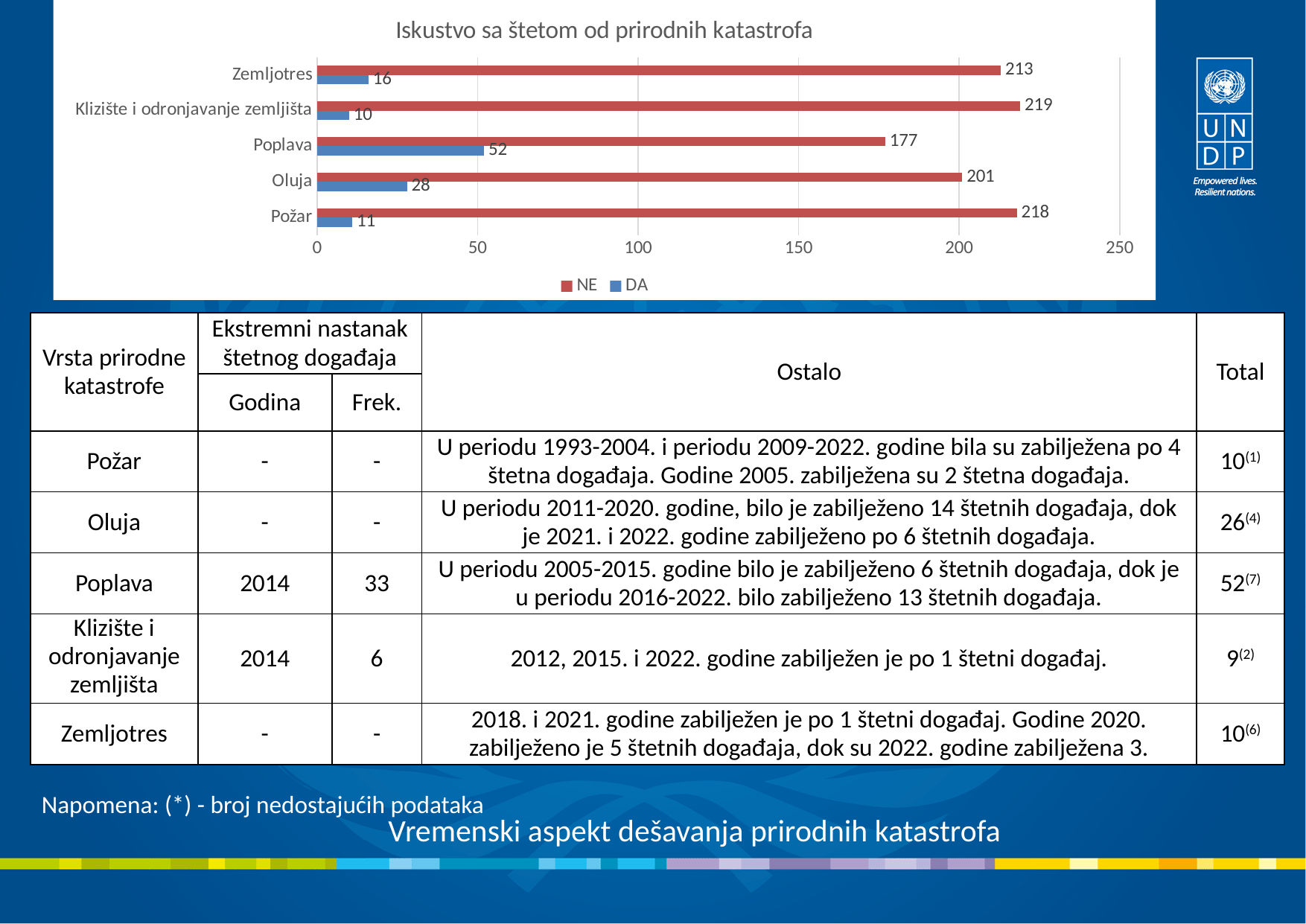
Which is larger, the DA value for Oluja or the DA value for Zemljotres? Oluja What is the title of the chart? Iskustvo sa štetom od prirodnih katastrofa What is the difference between the NE and DA values for Požar? 207 What kind of chart is shown on the slide? Bar chart What is the DA value for Klizište i odronjavanje zemljišta? 10 How many series does the legend list? 2 How many categories are shown on the chart? 5 What is the NE value for Oluja? 201 Which category has the lowest NE value? Poplava Which category has the highest DA value? Poplava What is the DA value for Poplava? 52 What is the NE value for Zemljotres? 213